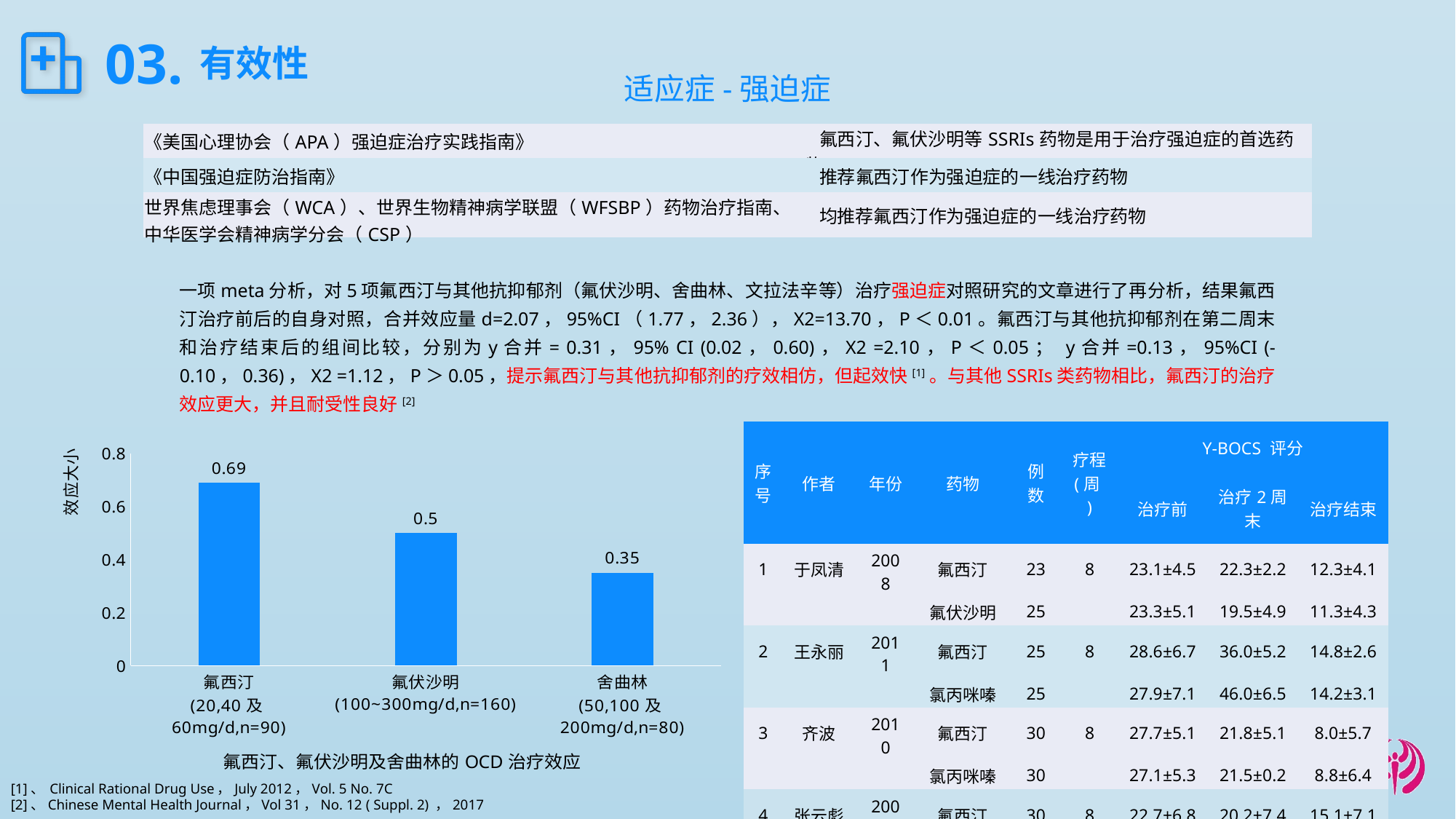
What is the difference between the effect sizes of 氟西汀 and 氟伏沙明 in the bar chart? 0.19 Which drug has the lowest effect size in the bar chart? 舍曲林 What is the difference between the effect sizes of 氟西汀 and 舍曲林 in the bar chart? 0.34 Is the effect size for 舍曲林 in the bar chart greater or less than 0.4? less What type of chart is used to show the OCD treatment effect sizes? bar chart Which drug has the highest effect size in the bar chart? 氟西汀 What is the label on the vertical axis of the bar chart? 效应大小 How many drugs (bars) are shown in the bar chart? 3 What is the effect size value shown for 氟伏沙明 in the bar chart? 0.5 What is the effect size value shown for 舍曲林 in the bar chart? 0.35 In the bar chart, which has a larger effect size, 氟伏沙明 or 舍曲林? 氟伏沙明 What is the effect size value shown for 氟西汀 in the bar chart? 0.69